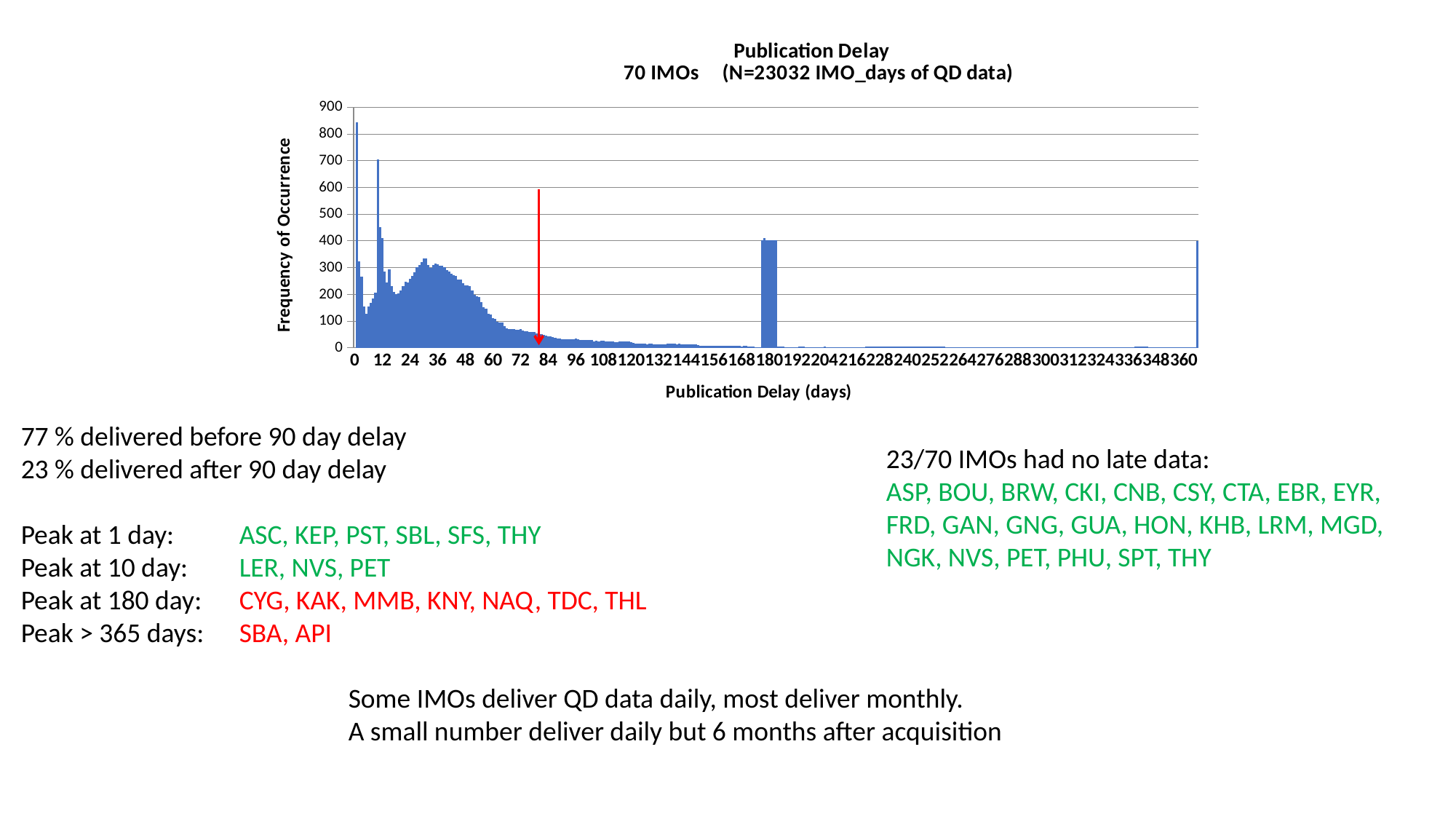
What is the title of the chart? Publication Delay 70 IMOs (N=23032 IMO_days of QD data) Does the frequency of occurrence rise or fall as publication delay increases from 36 days to 96 days? fall What is the highest value shown on the y axis of the chart? 900 Is the frequency of occurrence at 120 days greater or less than 100? less Is the frequency of occurrence for the bar at 180 days greater or less than 300? greater What kind of chart is shown on the slide? bar chart Which is larger, the frequency of occurrence at the spike near 0 days or at the spike near 12 days? near 0 days Is the frequency of occurrence for the spike near 12 days greater or less than 600? greater What is the label of the y axis of the chart? Frequency of Occurrence